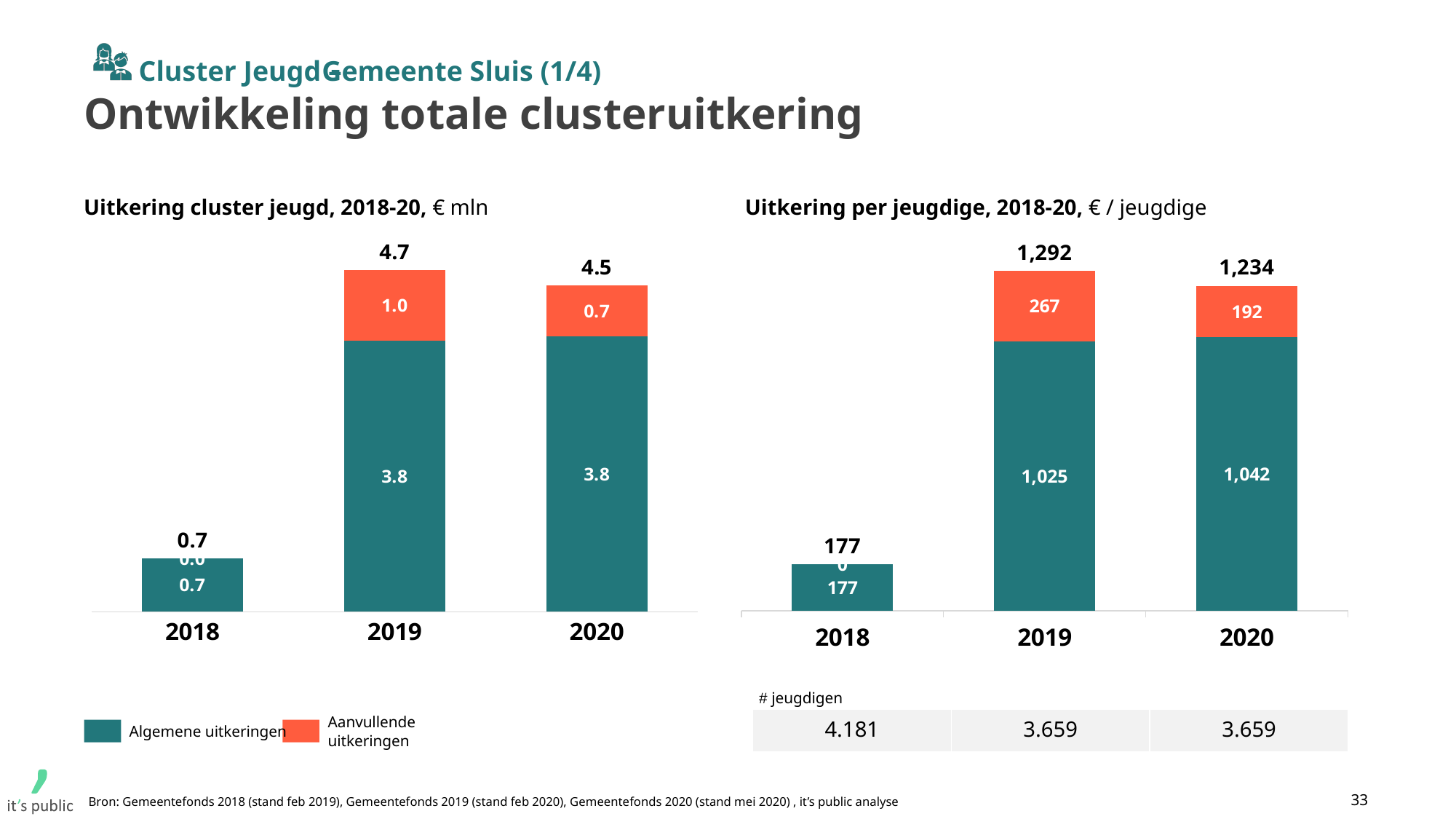
In the chart 'Uitkering cluster jeugd, 2018-20', what is the difference between the totals for 2019 and 2020? 0.2 In the chart 'Uitkering per jeugdige, 2018-20', is the total for 2020 larger or smaller than the total for 2019? smaller In the chart 'Uitkering cluster jeugd, 2018-20', what is the value of Algemene uitkeringen for 2020? 3.8 What type of chart is 'Uitkering cluster jeugd, 2018-20'? Stacked bar chart In the chart 'Uitkering per jeugdige, 2018-20', which year has the highest total? 2019 In the chart 'Uitkering per jeugdige, 2018-20', what is the value of Algemene uitkeringen for 2019? 1,025 In the chart 'Uitkering cluster jeugd, 2018-20', which year has the lowest total? 2018 In the chart 'Uitkering cluster jeugd, 2018-20', what is the total value of the bar for 2019? 4.7 How many series does the legend list for the charts on this slide? 2 In the chart 'Uitkering cluster jeugd, 2018-20', what is the value of Aanvullende uitkeringen for 2019? 1.0 In the chart 'Uitkering per jeugdige, 2018-20', what is the difference between the Aanvullende uitkeringen values for 2019 and 2020? 75 In the chart 'Uitkering per jeugdige, 2018-20', what is the value of Aanvullende uitkeringen for 2020? 192